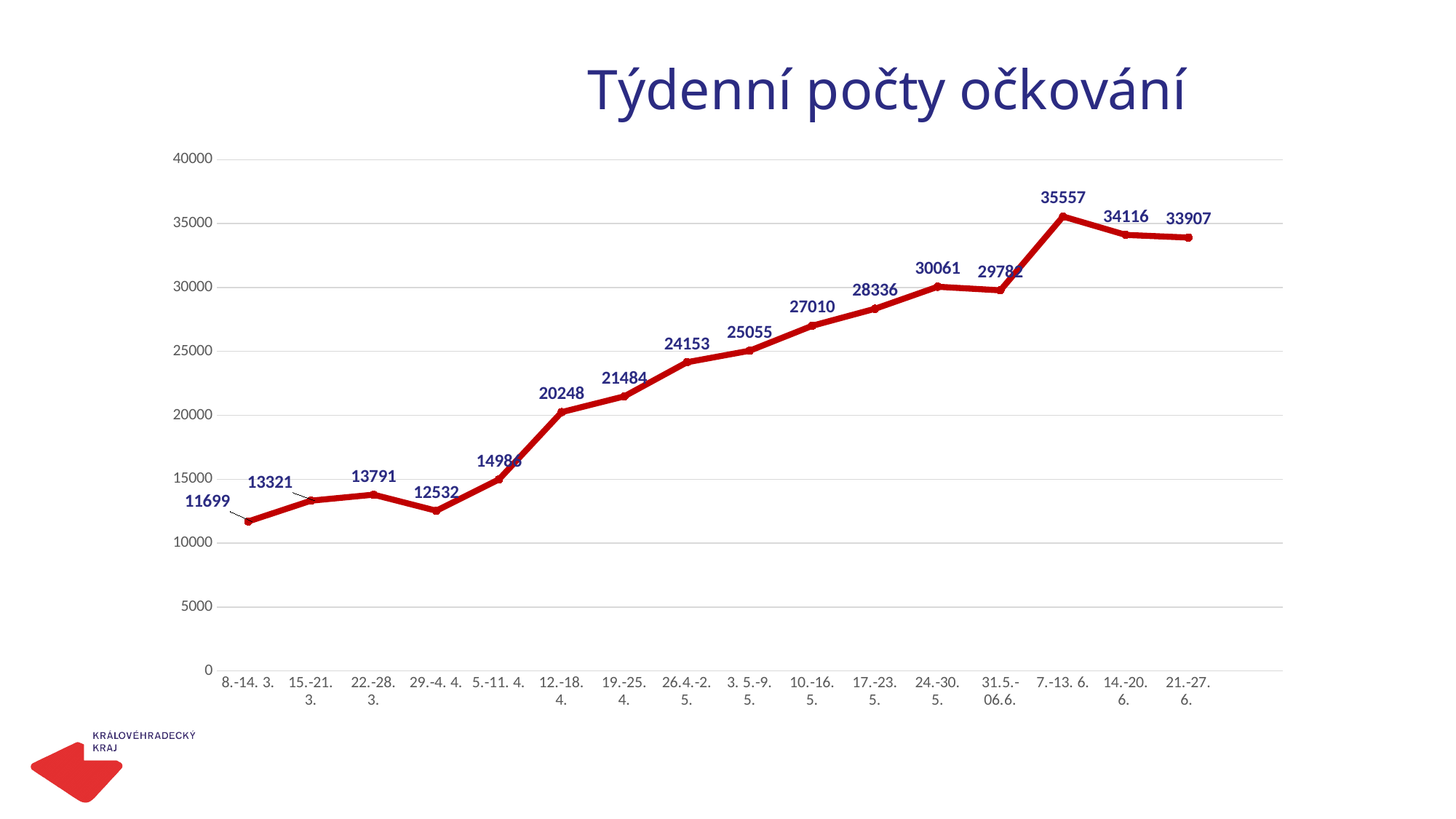
Which week has the highest value? 7.-13. 6. What is the title of the chart? Týdenní počty očkování What is the value for the week 24.-30. 5.? 30061 What is the value for the week 8.-14. 3.? 11699 How many weekly data points are plotted on the chart? 16 Is the value for 26.4.-2. 5. greater or less than 25000? less What is the difference between the values for 7.-13. 6. and 14.-20. 6.? 1441 Which week has the lowest value? 8.-14. 3. Which is larger, the value for 22.-28. 3. or the value for 29.-4. 4.? 22.-28. 3. What type of chart is shown on the slide? line chart What is the value for the week 21.-27. 6.? 33907 What is the value for the week 12.-18. 4.? 20248